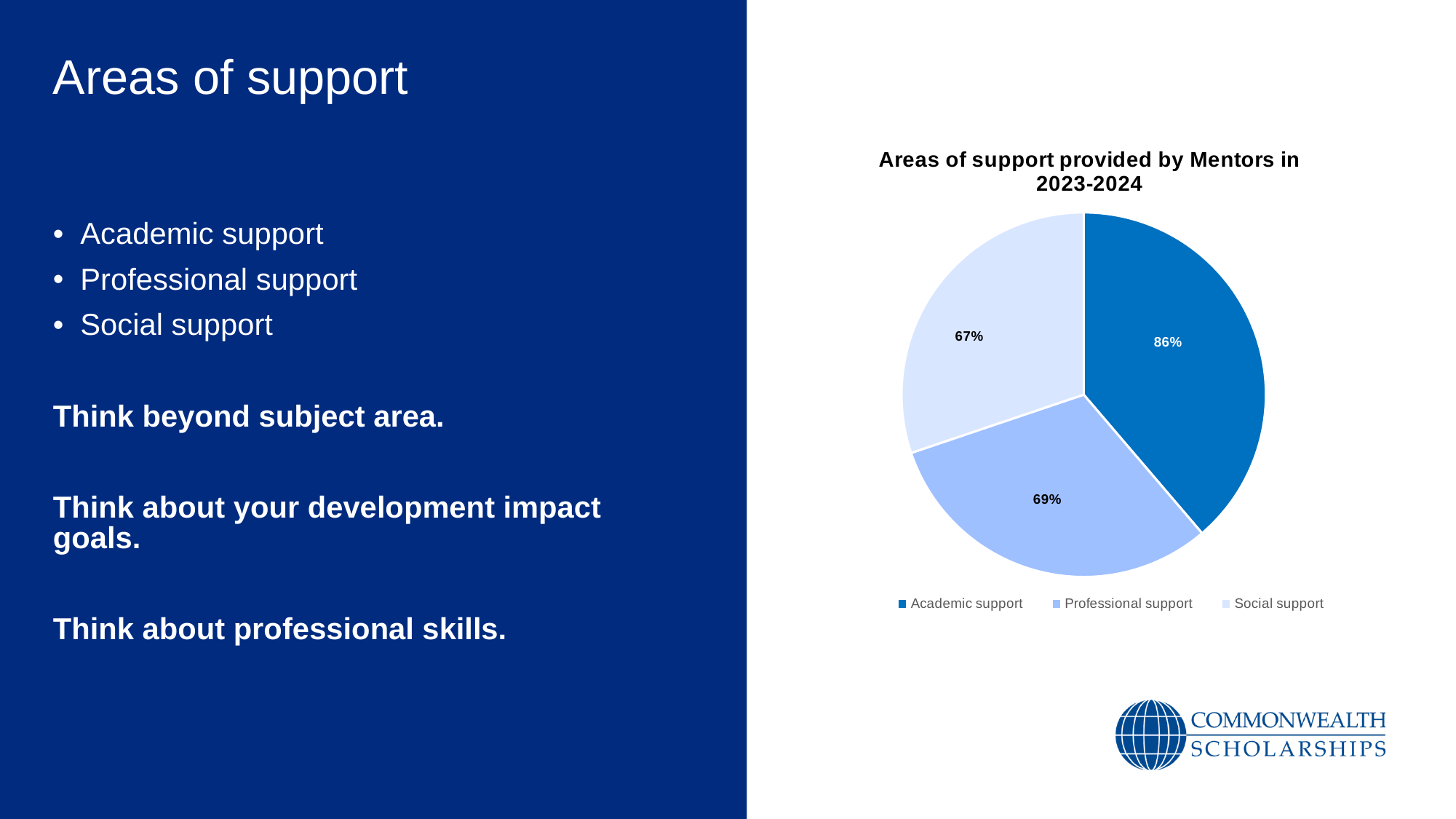
How many entries does the chart legend list? 3 What value is shown for Social support in the pie chart? 67% Which area of support has the highest value in the pie chart? Academic support Which is larger, the value for Academic support or the value for Social support? Academic support What value is shown for Professional support in the pie chart? 69% What type of chart is shown on the slide? Pie chart What value is shown for Academic support in the pie chart? 86% What is the difference between the values for Academic support and Social support? 19% What is the difference between the values for Academic support and Professional support? 17% Which area of support has the lowest value in the pie chart? Social support What is the title of the chart? Areas of support provided by Mentors in 2023-2024 How many slices does the pie chart have? 3